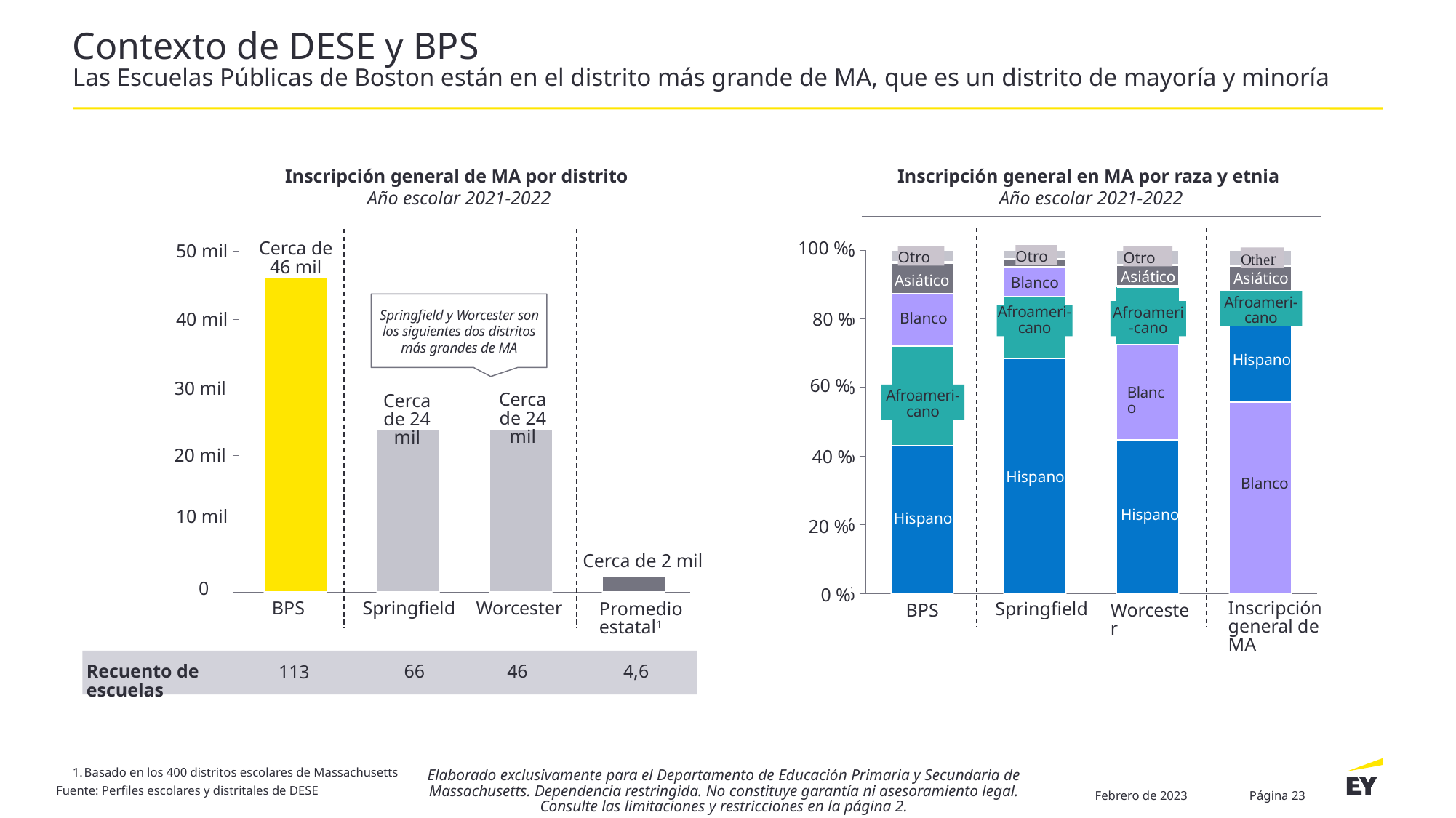
In the chart 'Inscripción general de MA por distrito', how many bars are plotted? 4 In the chart 'Inscripción general en MA por raza y etnia', is the Hispano share for Springfield greater or less than 60%? greater In the 'Recuento de escuelas' row under the left chart, what is the value for BPS? 113 In the chart 'Inscripción general de MA por distrito', is the value for BPS greater or less than 40 mil? greater In the chart 'Inscripción general de MA por distrito', what data label is printed above the BPS bar? Cerca de 46 mil What kind of chart is 'Inscripción general en MA por raza y etnia'? Stacked bar chart In the chart 'Inscripción general de MA por distrito', which district has the highest enrollment? BPS In the chart 'Inscripción general en MA por raza y etnia', which group forms the bottom segment of the BPS bar? Hispano In the chart 'Inscripción general de MA por distrito', which bar is the lowest? Promedio estatal In the chart 'Inscripción general en MA por raza y etnia', is the Blanco share for 'Inscripción general de MA' greater or less than 50%? greater In the 'Recuento de escuelas' row under the left chart, what is the difference between BPS and Springfield? 47 In the 'Recuento de escuelas' row under the left chart, what is the value for Promedio estatal? 4,6